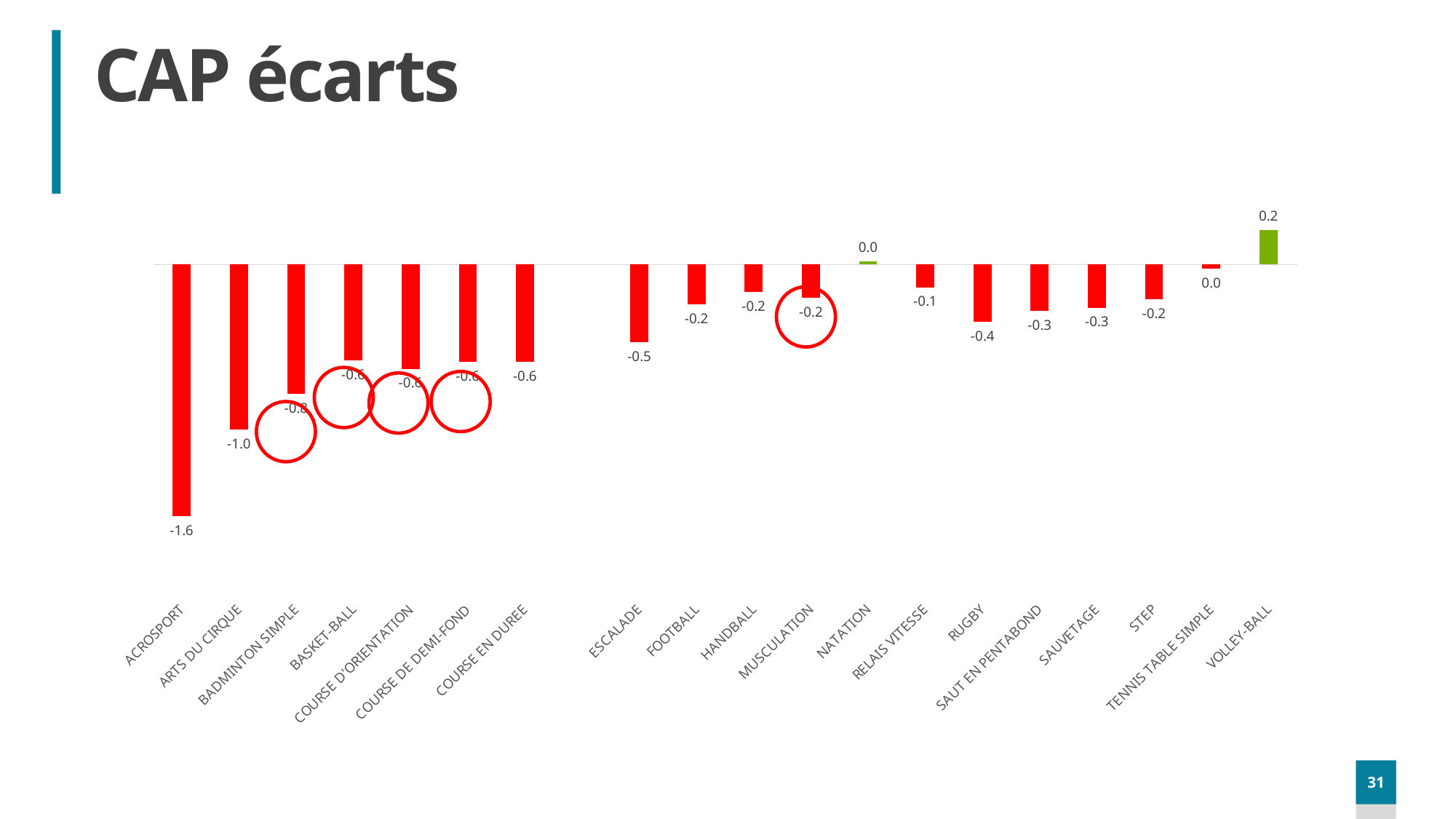
What is the difference between the values for ARTS DU CIRQUE and ACROSPORT? 0.6 Which has the larger value, RUGBY or SAUVETAGE? SAUVETAGE What colour is the bar for VOLLEY-BALL? Green Which category has the highest value? VOLLEY-BALL What is the value for NATATION? 0.0 What is the value for RUGBY? -0.4 What is the value for ESCALADE? -0.5 What kind of chart is shown on the slide? Bar chart What is the title of the slide? CAP écarts Which category has the lowest value? ACROSPORT What is the value for VOLLEY-BALL? 0.2 What is the value for ACROSPORT? -1.6